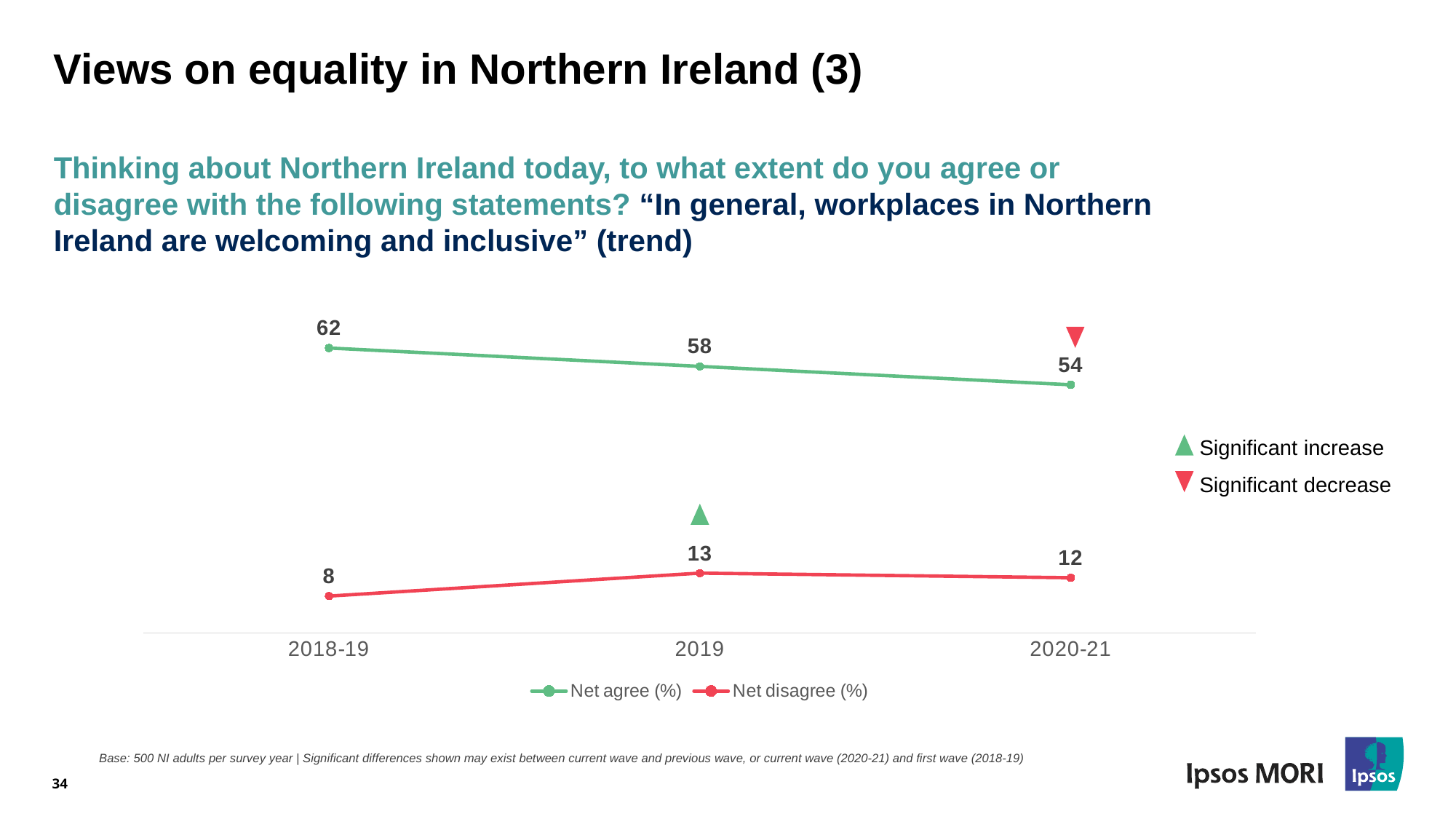
How many survey years are plotted on the x axis? 3 What is the difference between Net agree (%) in 2018-19 and 2020-21? 8 What is the Net agree (%) value for 2020-21? 54 Does Net agree (%) rise or fall from 2018-19 to 2020-21? Fall What is the Net agree (%) value for 2018-19? 62 What kind of chart is shown on the slide? Line chart What is the Net disagree (%) value for 2018-19? 8 How many series does the chart legend list? 2 What is the Net disagree (%) value for 2019? 13 In which year is Net disagree (%) lowest? 2018-19 Which is larger in 2019: Net agree (%) or Net disagree (%)? Net agree (%) In which year is Net agree (%) highest? 2018-19